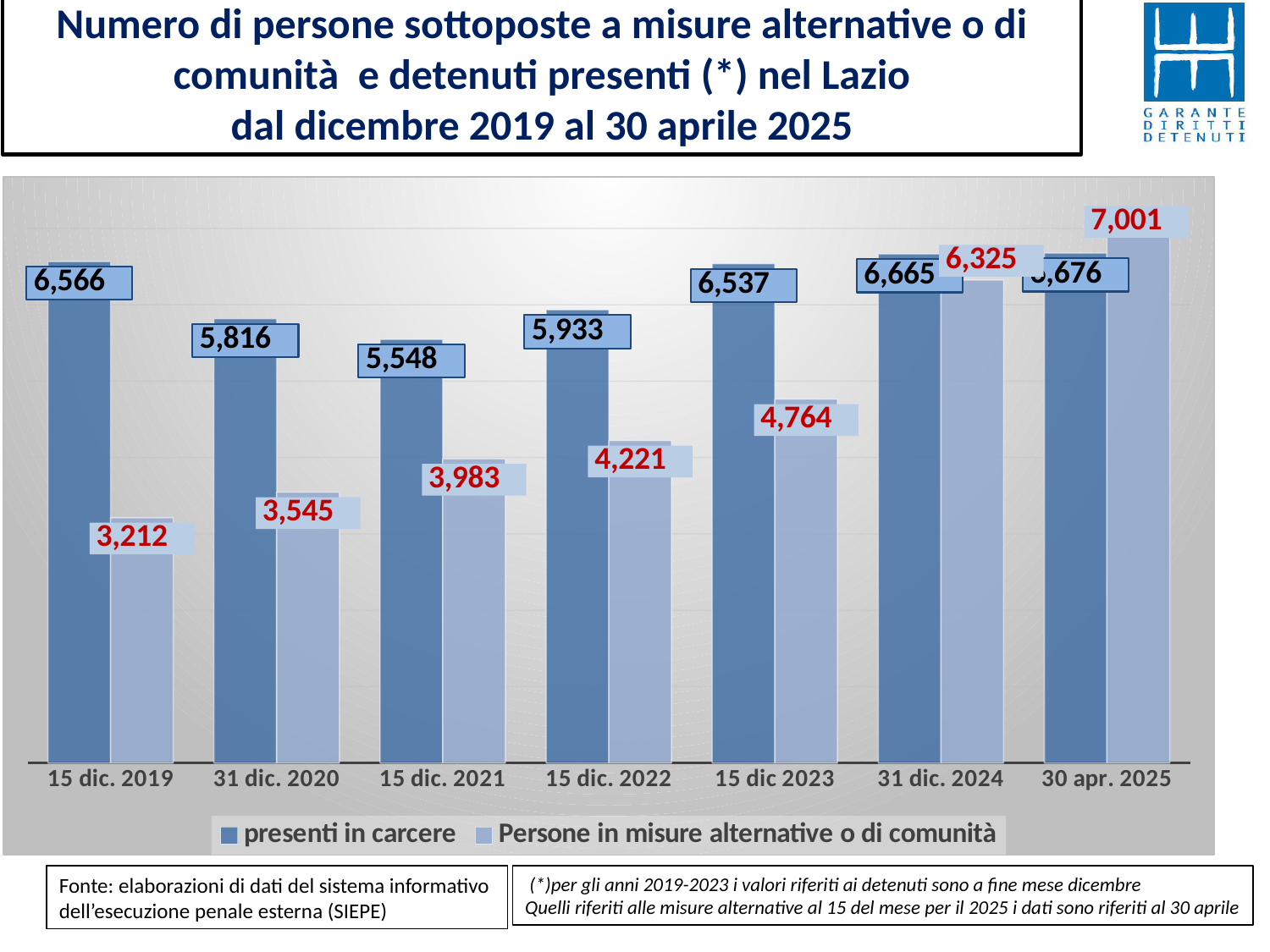
Do the values for 'Persone in misure alternative o di comunità' rise or fall from 15 dic. 2019 to 30 apr. 2025? Rise At which date is the value for 'presenti in carcere' lowest? 15 dic. 2021 How many series does the legend list? 2 What kind of chart is shown on the slide? Bar chart What is the difference between 'presenti in carcere' and 'Persone in misure alternative o di comunità' at 15 dic. 2019? 3,354 At which date is the value for 'Persone in misure alternative o di comunità' highest? 30 apr. 2025 How many dates are shown along the x axis? 7 What is the value for 'Persone in misure alternative o di comunità' at 15 dic 2023? 4,764 What is the value for 'presenti in carcere' at 15 dic. 2019? 6,566 At 30 apr. 2025, which series has the larger value? Persone in misure alternative o di comunità Which series is shown in the darker blue bars? presenti in carcere What is the value for 'presenti in carcere' at 31 dic. 2024? 6,665